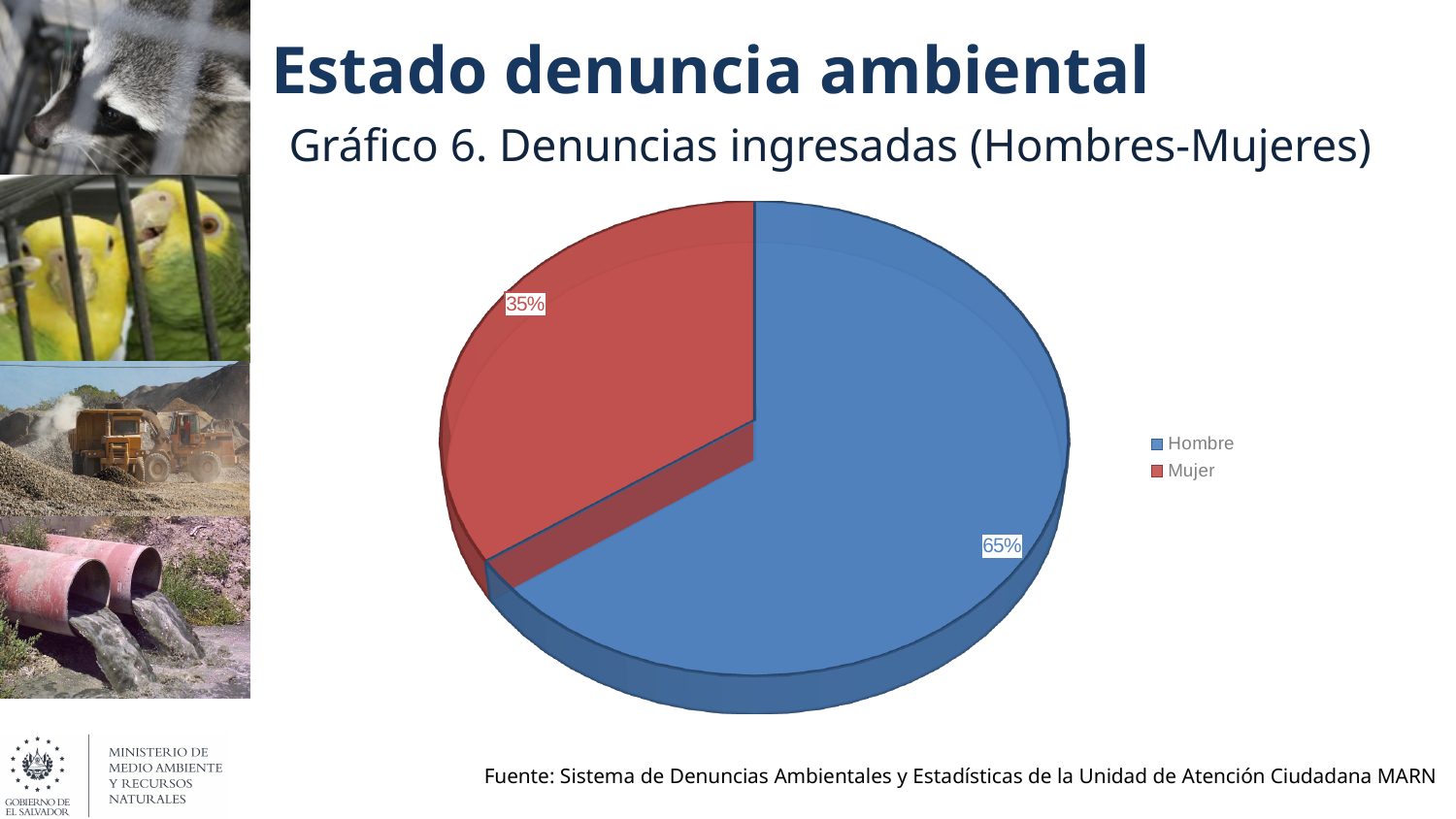
Which category has the largest slice of the pie? Hombre How many categories does the pie chart show? 2 What is the difference in percentage points between the Hombre and Mujer slices? 30 How many entries does the legend list? 2 Which slice is larger, Hombre or Mujer? Hombre What is the title of the chart? Gráfico 6. Denuncias ingresadas (Hombres-Mujeres) What kind of chart is shown on the slide? Pie chart Which category has the smallest slice of the pie? Mujer What share of the pie does Mujer represent? 35% What colour is the Mujer slice in the pie chart? Red What share of the pie does Hombre represent? 65%